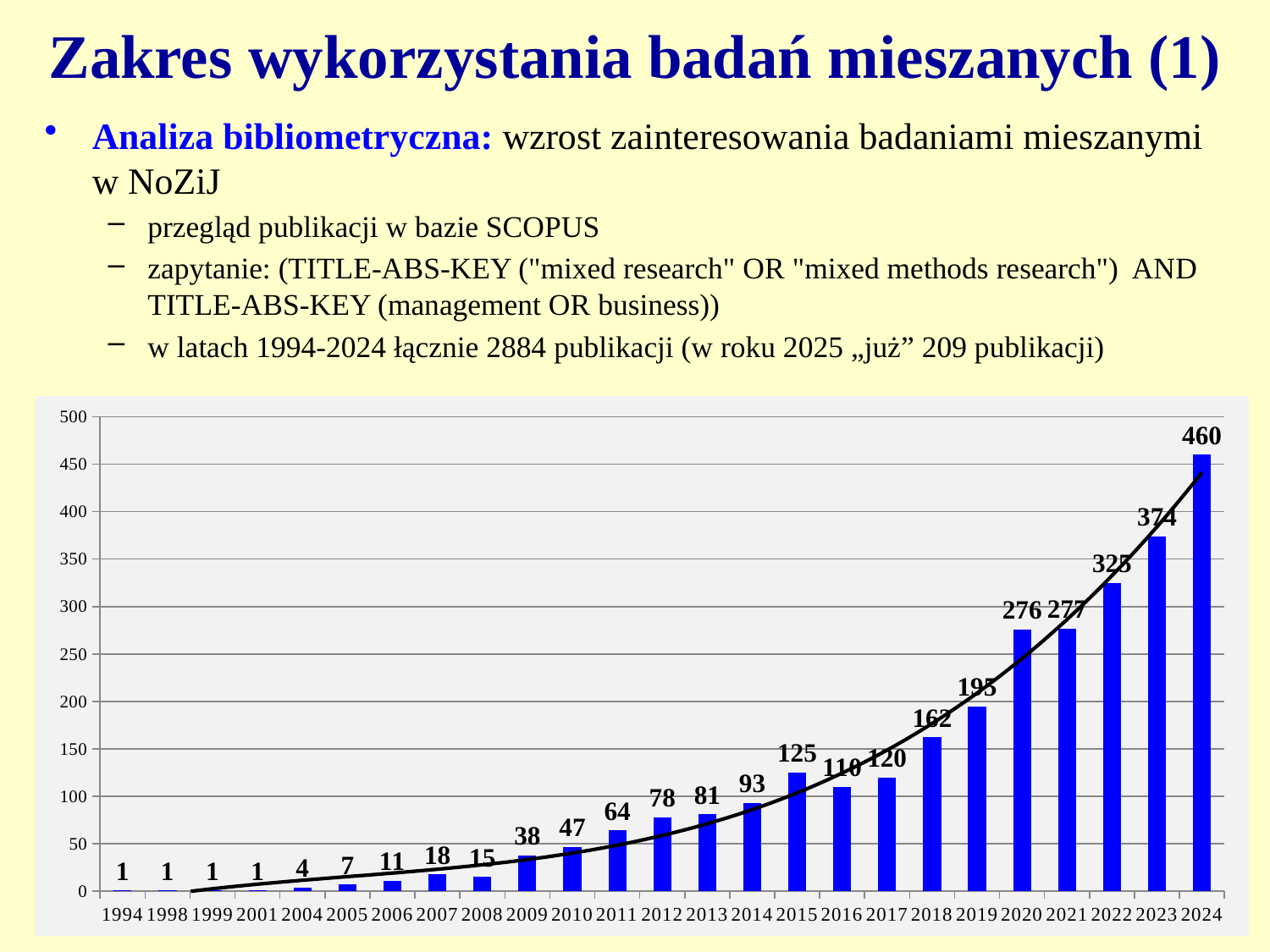
Which year has the highest value? 2024 Which is larger, the value for 2015 or the value for 2016? 2015 What kind of chart is shown on the slide? bar chart Do the values generally rise or fall from 1994 to 2024? rise What is the difference between the values for 2019 and 2018? 33 How many years are shown on the x axis? 25 What is the value for 2024? 460 What is the difference between the values for 2024 and 2023? 86 What is the value for 2009? 38 What is the value for 2008? 15 What is the value for 2015? 125 Is the value for 2022 greater or less than 300? greater